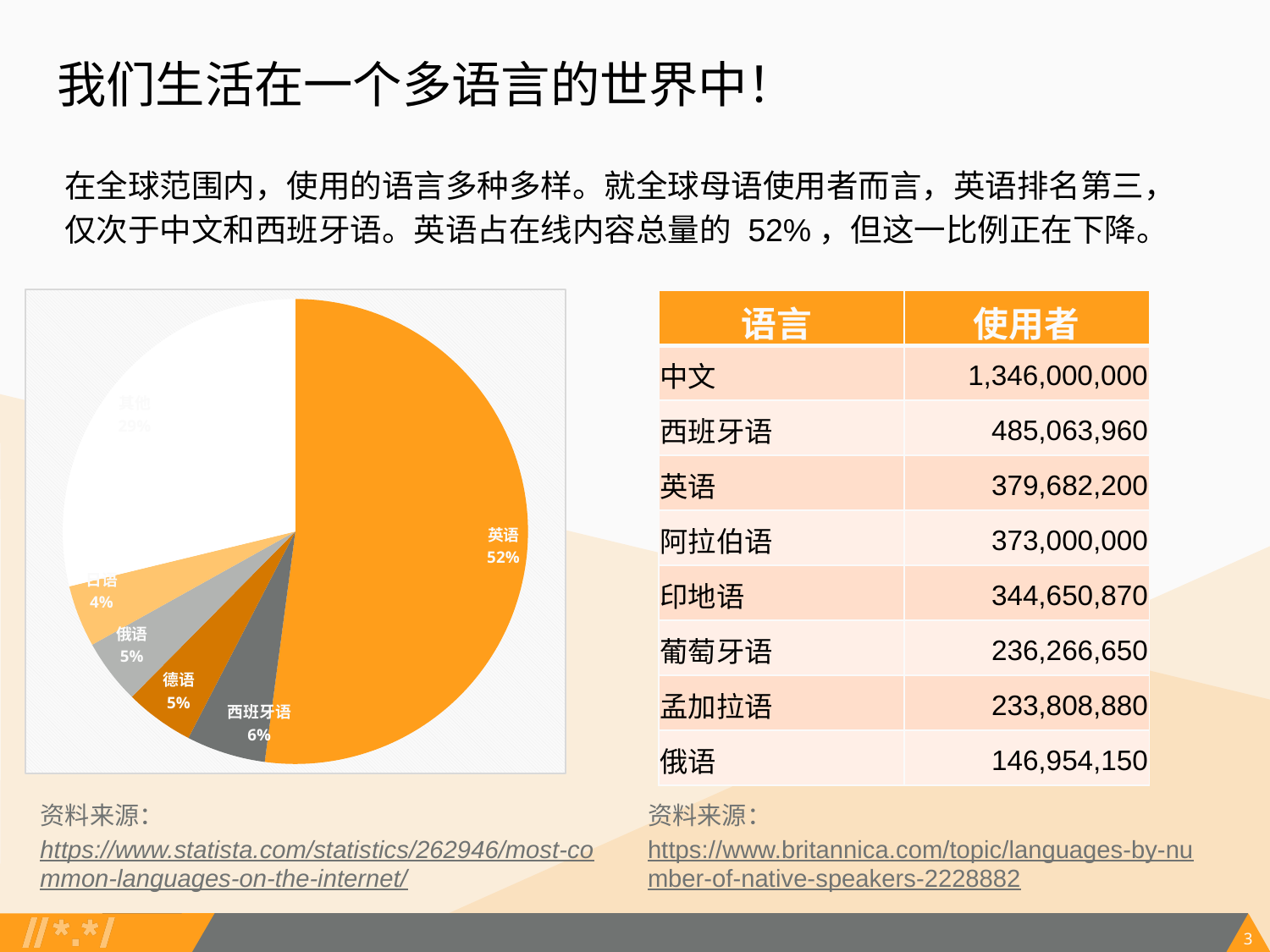
What colour is the 英语 slice in the pie chart? orange How many slices does the pie chart have? 6 In the pie chart, what share is shown for 俄语? 5% In the pie chart, what share is shown for 英语? 52% In the pie chart, what share is shown for 日语? 4% What kind of chart is shown on the left of the slide? pie chart In the pie chart, how many percentage points larger is the 西班牙语 share than the 日语 share? 2% In the pie chart, what share is shown for 德语? 5% In the pie chart, which slice is larger, 西班牙语 or 德语? 西班牙语 In the pie chart, what share is shown for 西班牙语? 6% Which slice of the pie chart is the largest? 英语 In the pie chart, how many percentage points larger is the 英语 share than the 西班牙语 share? 46%